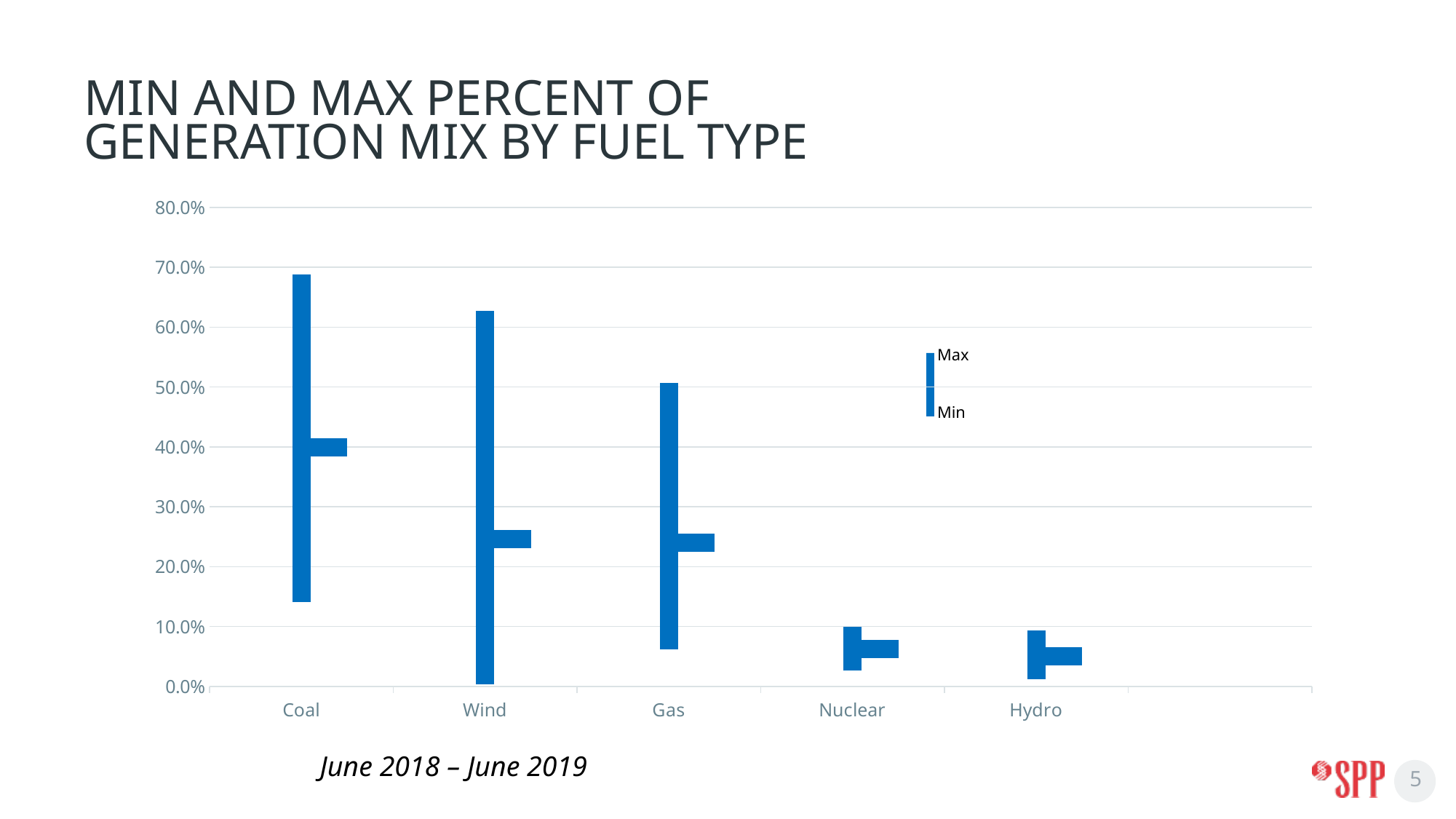
Is the maximum value for Coal greater or less than 60.0%? greater How many fuel types are shown on the x axis? 5 Is the maximum value for Gas greater or less than 40.0%? greater Do the maximum values rise or fall moving from Coal to Hydro along the x axis? fall What kind of chart is shown on the slide? bar chart Which fuel type has the highest maximum percent of generation mix? Coal Which fuel type has the lowest minimum percent of generation mix? Wind Is the maximum value for Nuclear greater or less than 20.0%? less How many entries does the legend list? 2 Which is larger, the maximum value for Coal or the maximum value for Wind? Coal